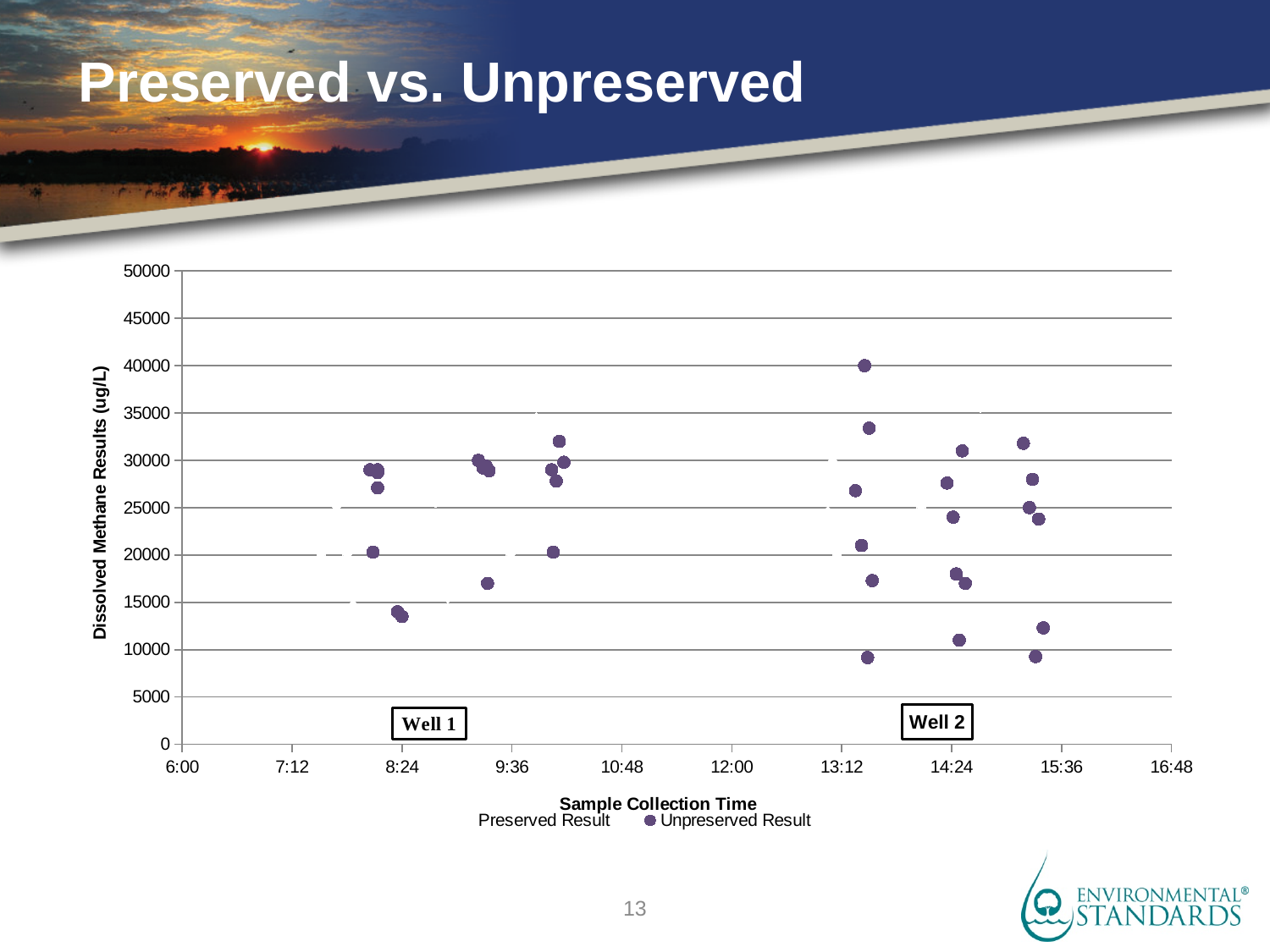
Is the lowest value in the Well 1 group greater or less than 15000? less What are the two series named in the legend? Preserved Result and Unpreserved Result Is the highest value in the Well 2 group greater or less than 35000? greater Is the highest plotted value on the chart greater or less than 35000? greater How many well groups are labelled on the chart? 2 How many series does the legend list? 2 Which labelled group contains the highest single plotted point, Well 1 or Well 2? Well 2 What kind of chart is shown on the slide? scatter chart What is the title of the y axis? Dissolved Methane Results (ug/L)